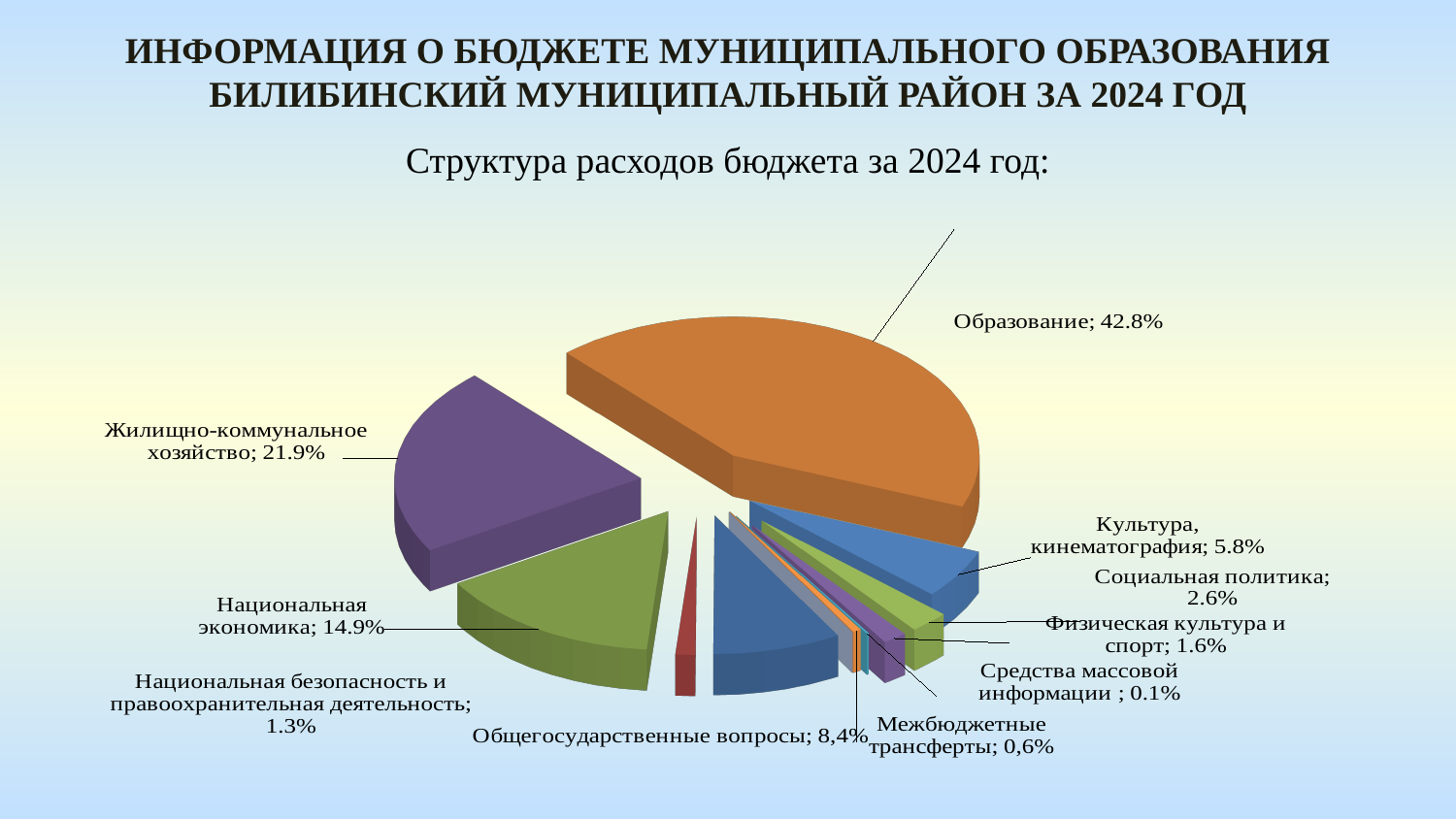
How many categories are shown in the pie chart? 10 What share is shown for Межбюджетные трансферты? 0,6% What percentage is shown for Национальная экономика? 14.9% What share of budget expenditure does Образование account for? 42.8% What is the value shown for Жилищно-коммунальное хозяйство? 21.9% What is the value for Общегосударственные вопросы? 8,4% What is the subtitle of the chart on the slide? Структура расходов бюджета за 2024 год: Which is larger: Культура, кинематография or Социальная политика? Культура, кинематография What kind of chart is shown on the slide? Pie chart How many percentage points larger is Образование than Жилищно-коммунальное хозяйство? 20.9 Which category has the smallest share of the pie? Средства массовой информации Which category has the largest share of the pie? Образование